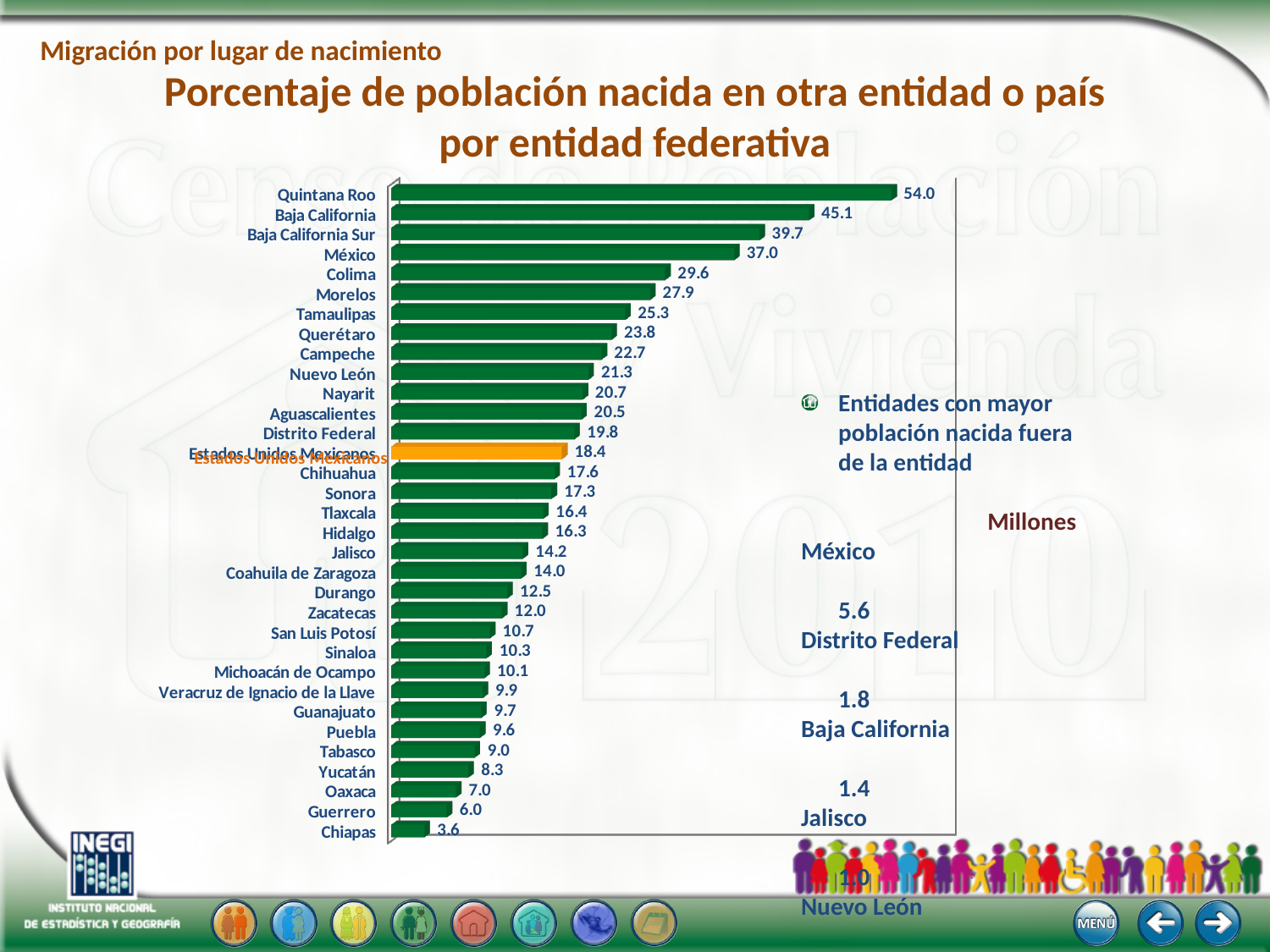
What is the difference between the values for Quintana Roo and Baja California? 8.9 How many bars does the chart show? 33 Which entity has the highest value? Quintana Roo What is the value for Nuevo León? 21.3 What is the value for Estados Unidos Mexicanos? 18.4 Which bar is highlighted in orange instead of green? Estados Unidos Mexicanos What is the value for Chiapas? 3.6 Which entity has the lowest value? Chiapas What kind of chart is shown on the slide? Bar chart What is the difference between the values for Jalisco and Oaxaca? 7.2 What is the value for Quintana Roo? 54.0 Which has a larger value, Colima or Morelos? Colima